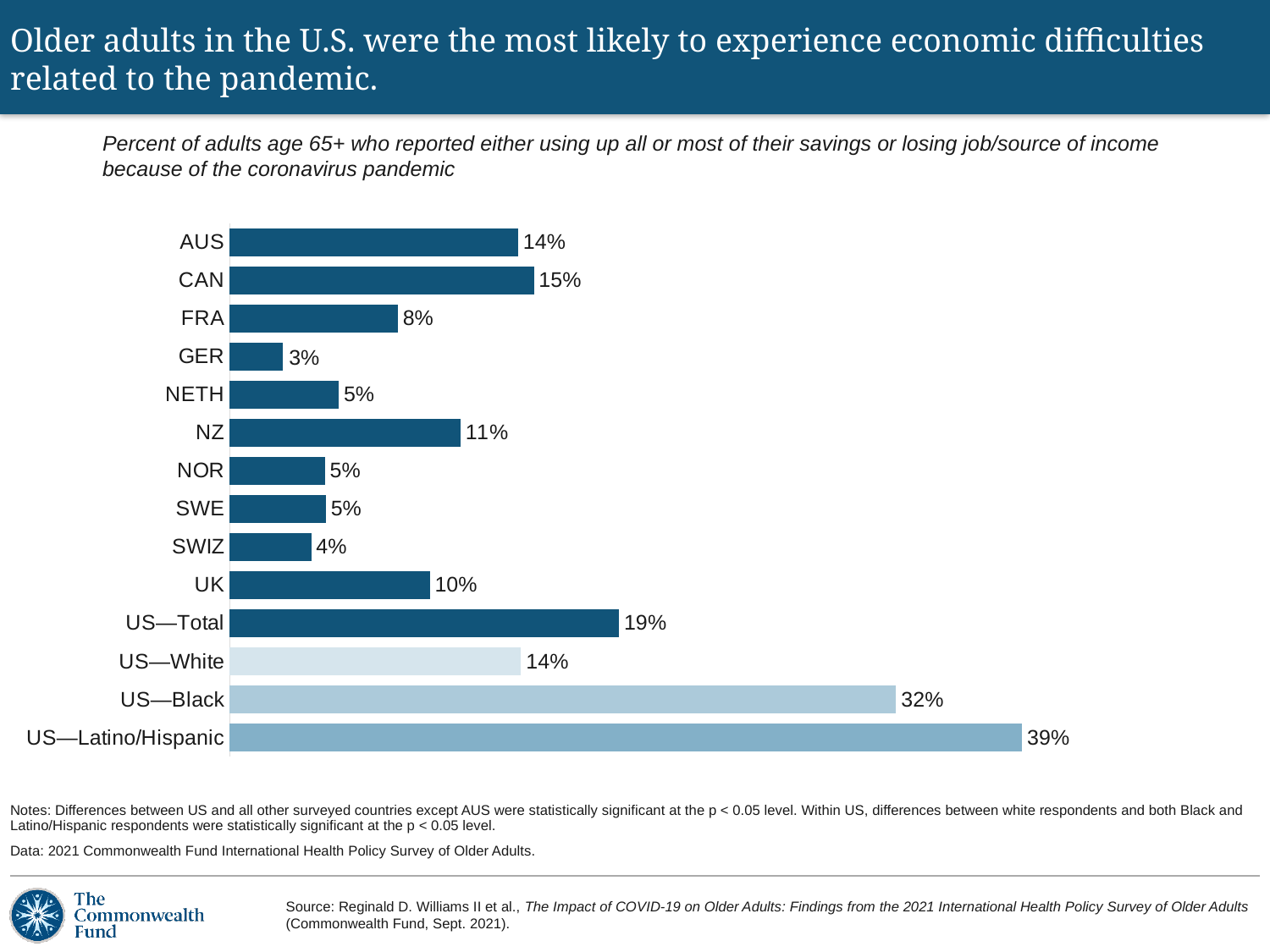
Which category has the highest value? US—Latino/Hispanic Which is larger, the value for FRA or the value for UK? UK What kind of chart is shown on the slide? Bar chart What is the difference between the values for US—Black and US—White? 18% Which three categories share the same value of 5%? NETH, NOR, SWE How many categories are shown in the chart? 14 What is the value for US—Total? 19% What is the difference between the values for US—Latino/Hispanic and US—Total? 20% What is the value for CAN? 15% Which category has the lowest value? GER Which is larger, the value for AUS or the value for SWIZ? AUS What is the value for NZ? 11%